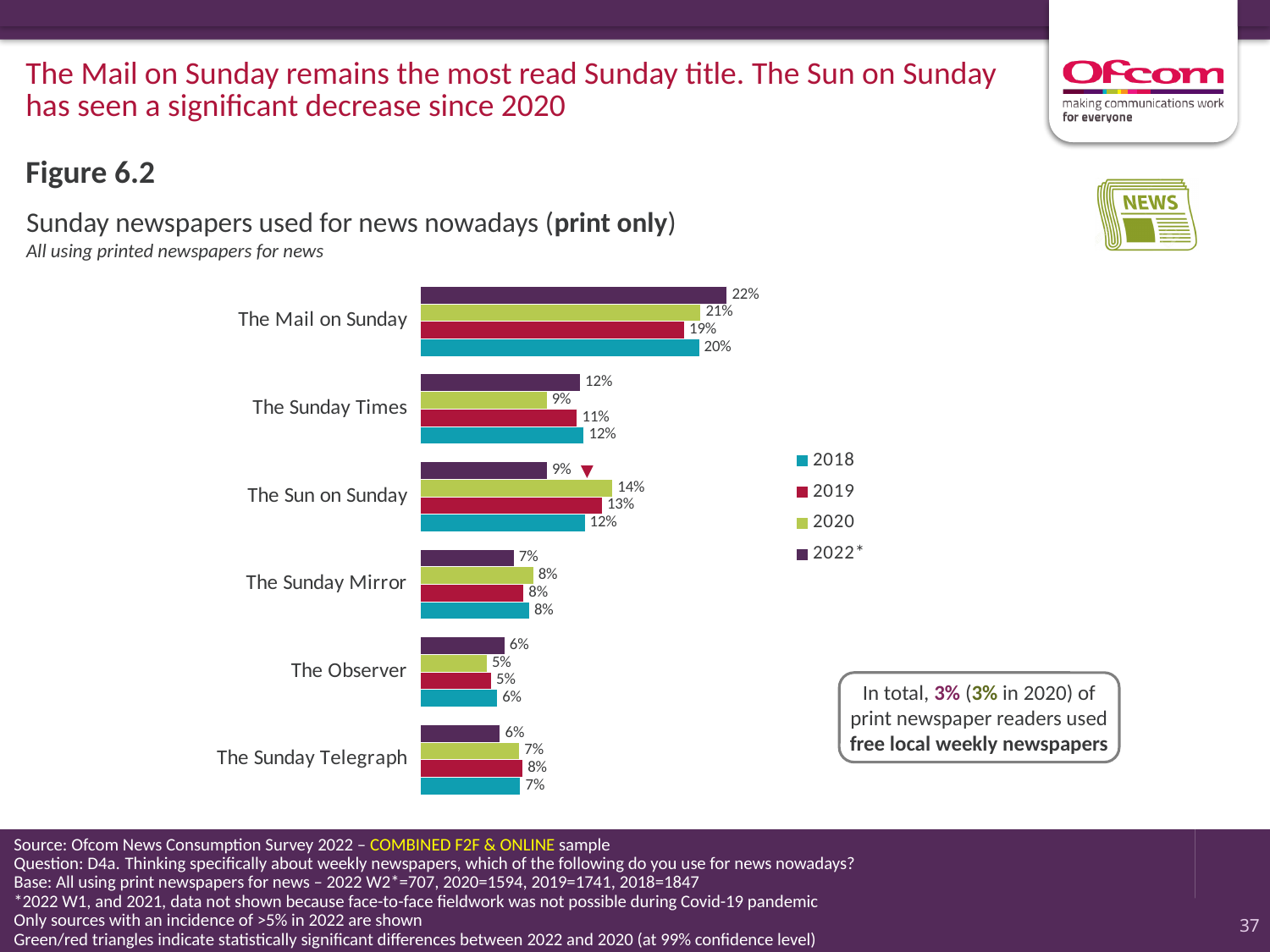
What percentage of print newspaper readers used The Mail on Sunday for news in 2022? 22% What was the value for The Sun on Sunday in 2020? 14% Which Sunday newspaper had the lowest value in 2020? The Observer Which year is marked with an asterisk in the legend? 2022* By how many percentage points did The Sun on Sunday fall between 2020 and 2022? 5 percentage points What is the difference between The Mail on Sunday and The Sunday Times in 2022? 10 percentage points How many years (series) does the legend list? 4 In 2019, which was larger: The Sunday Times or The Sun on Sunday? The Sun on Sunday What type of chart is used on this slide? Bar chart What was the value for The Sunday Times in 2018? 12% How many Sunday newspapers are shown in the chart? 6 Which Sunday newspaper had the highest value in 2022? The Mail on Sunday